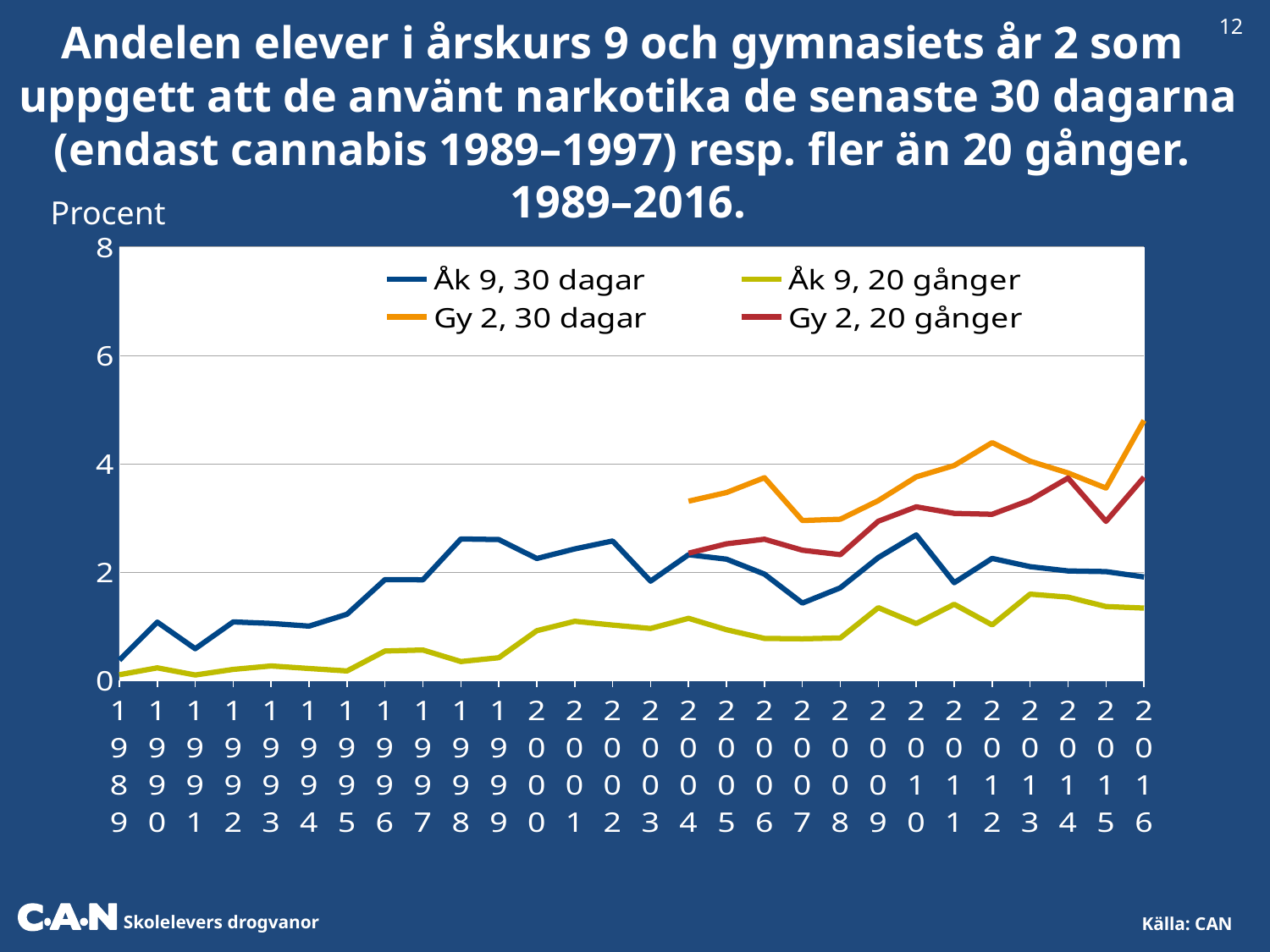
In 2016, which is higher: Åk 9, 30 dagar or Åk 9, 20 gånger? Åk 9, 30 dagar Which series has the highest value in 2016? Gy 2, 30 dagar How many series does the legend list? 4 Does the Åk 9, 30 dagar series rise or fall overall from 1989 to 2016? rise Is the value for Gy 2, 20 gånger in 2016 greater or less than 2? greater How many years are shown on the x axis? 28 What is the label on the y axis? Procent Is the value for Gy 2, 30 dagar in 2016 greater or less than 4? greater In 2016, which is higher: Gy 2, 30 dagar or Åk 9, 30 dagar? Gy 2, 30 dagar What type of chart is shown on the slide? line chart Is the value for Åk 9, 20 gånger in 2016 greater or less than 2? less